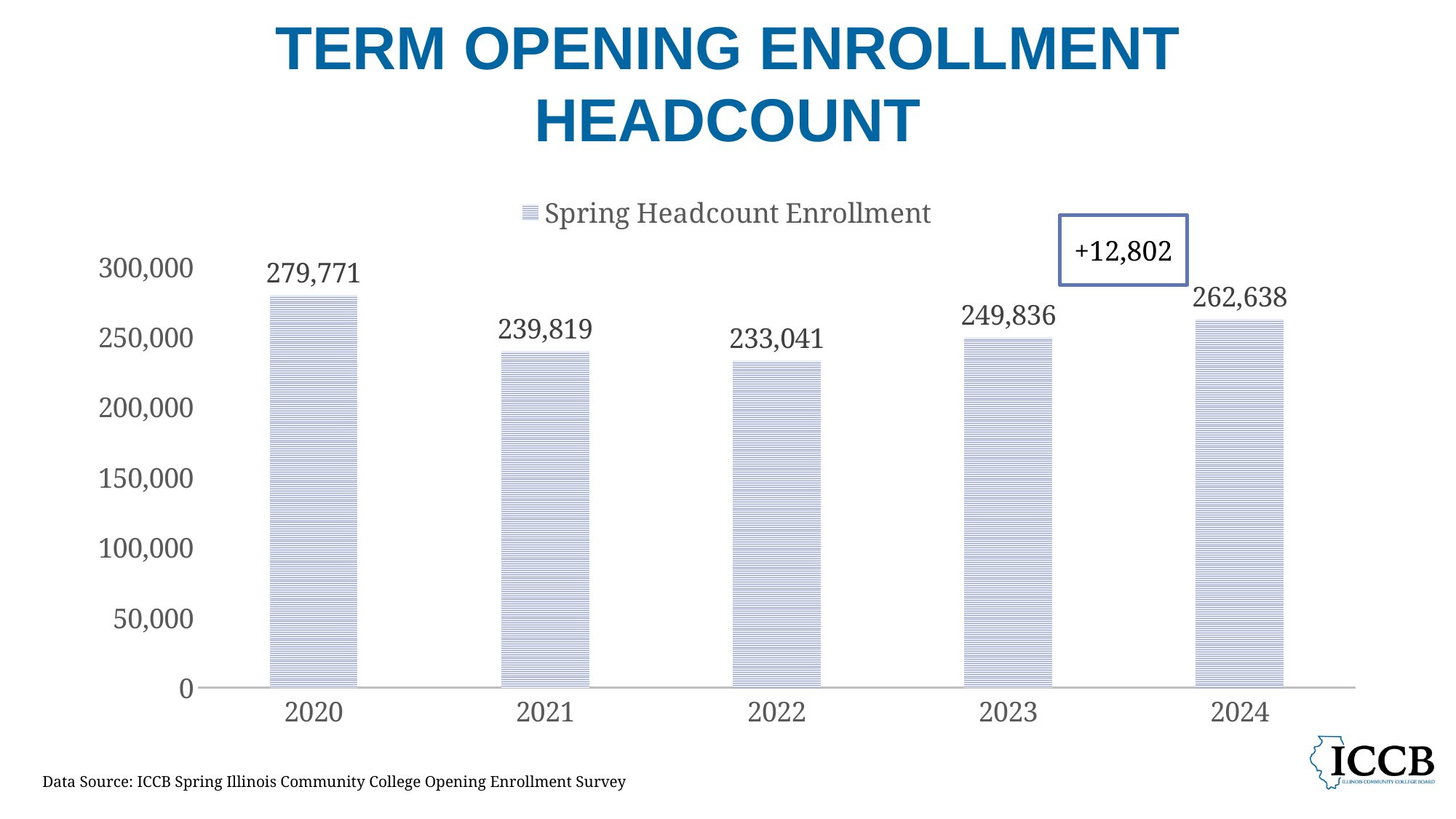
Which year has the lowest Spring Headcount Enrollment? 2022 Which year has the highest Spring Headcount Enrollment? 2020 What is the difference in Spring Headcount Enrollment between 2020 and 2021? 39,952 Is the Spring Headcount Enrollment for 2022 greater or less than 250,000? less What is the difference in Spring Headcount Enrollment between 2024 and 2023? 12,802 Does the Spring Headcount Enrollment rise or fall from 2022 to 2024? rise What kind of chart is shown on the slide? bar chart How many years are shown on the x axis? 5 Which year has a larger Spring Headcount Enrollment, 2021 or 2023? 2023 What is the Spring Headcount Enrollment for 2022? 233,041 What is the Spring Headcount Enrollment for 2020? 279,771 What is the Spring Headcount Enrollment for 2024? 262,638